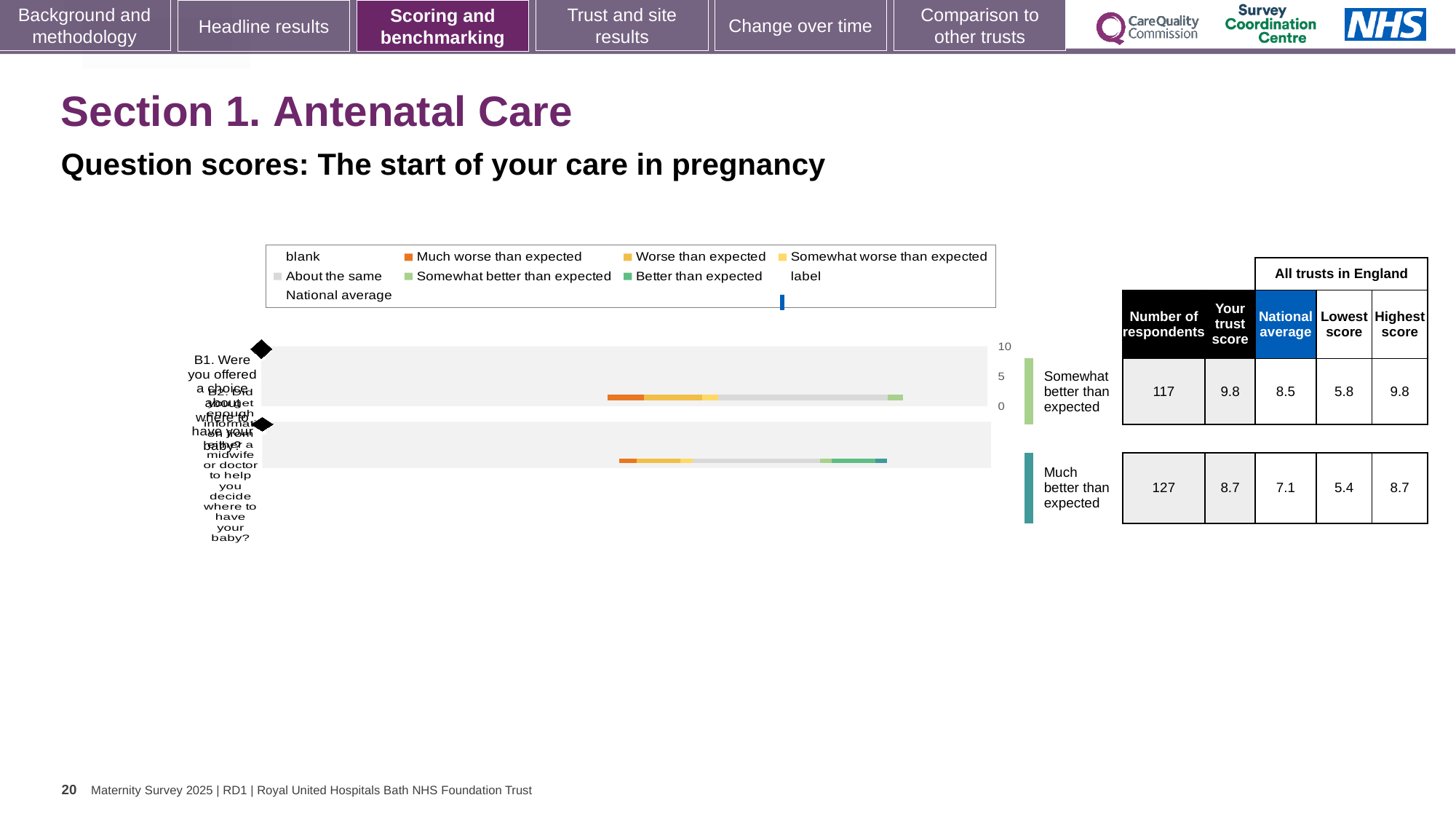
In the chart legend, what colour is the 'National average' marker? blue What is the trust score for question B2 (Did you get enough information from a midwife or doctor to help you decide where to have your baby?)? 8.7 Which benchmark category is shown next to question B2? Much better than expected What is the difference between the trust score and the national average for question B2? 1.6 What is the national average score for question B1? 8.5 What kind of chart is used to show the question scores for B1 and B2? bar chart What is the lowest score across all trusts in England for question B2? 5.4 Which question has more respondents, B1 or B2? B2 What is the number of respondents for question B1 (Were you offered a choice about where to have your baby?)? 117 In the chart legend, what colour represents 'Much worse than expected'? orange How many questions (bars) are plotted in the chart? 2 What is the highest score across all trusts in England for question B1? 9.8